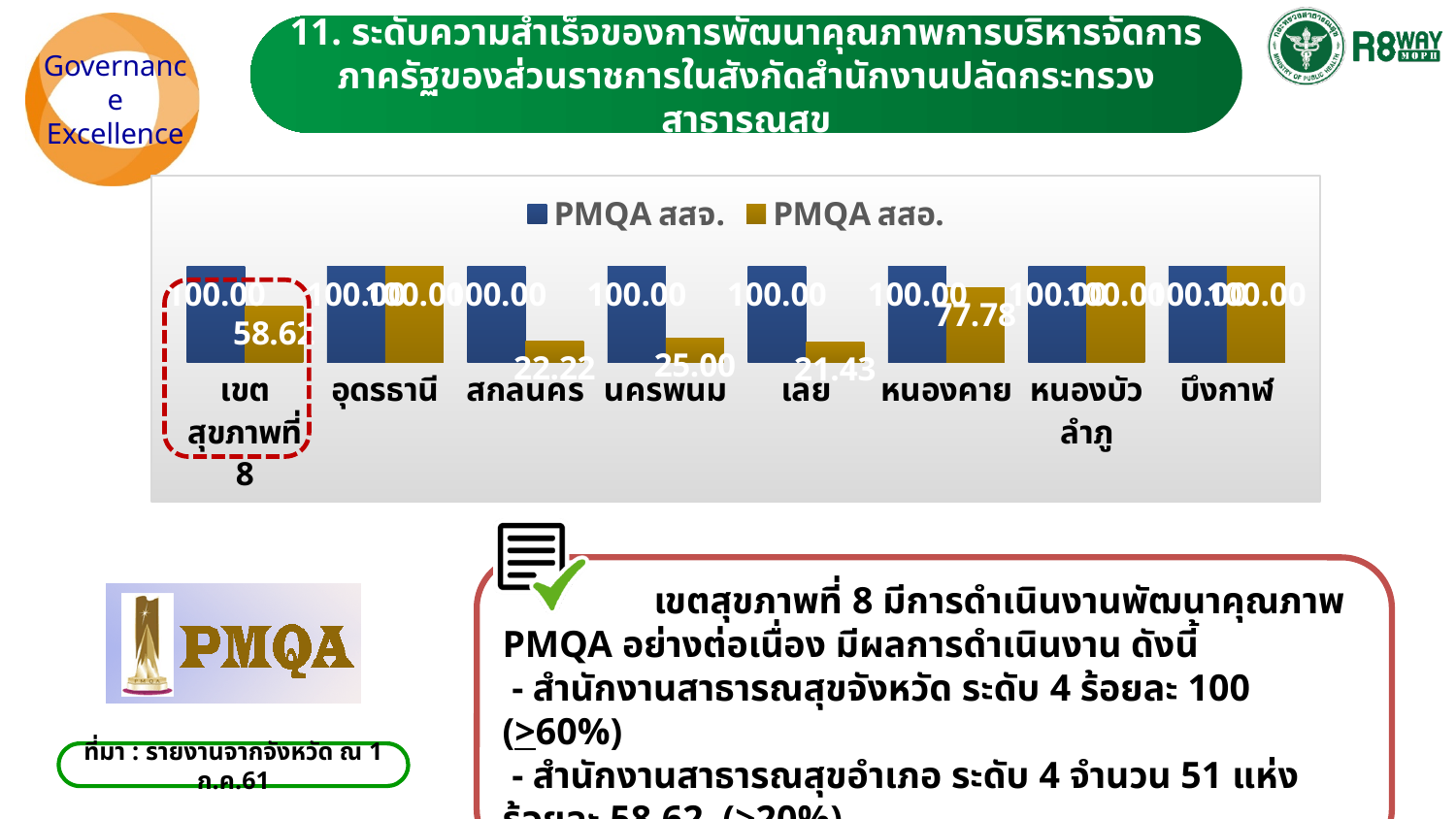
What is the difference between the PMQA สสอ. values for หนองคาย and เลย? 56.35 What is the PMQA สสอ. value for สกลนคร? 22.22 What kind of chart is shown on the slide? bar chart What is the PMQA สสอ. value for เขตสุขภาพที่ 8? 58.62 What is the PMQA สสจ. value for เลย? 100.00 Which is larger, the PMQA สสอ. value for นครพนม or for หนองคาย? หนองคาย Which province has the lowest PMQA สสอ. value? เลย What is the difference between the PMQA สสจ. and PMQA สสอ. values for เขตสุขภาพที่ 8? 41.38 What is the PMQA สสอ. value for หนองคาย? 77.78 Which legend entry is shown in blue? PMQA สสจ. How many series does the chart legend list? 2 How many categories are shown on the x axis of the chart? 8